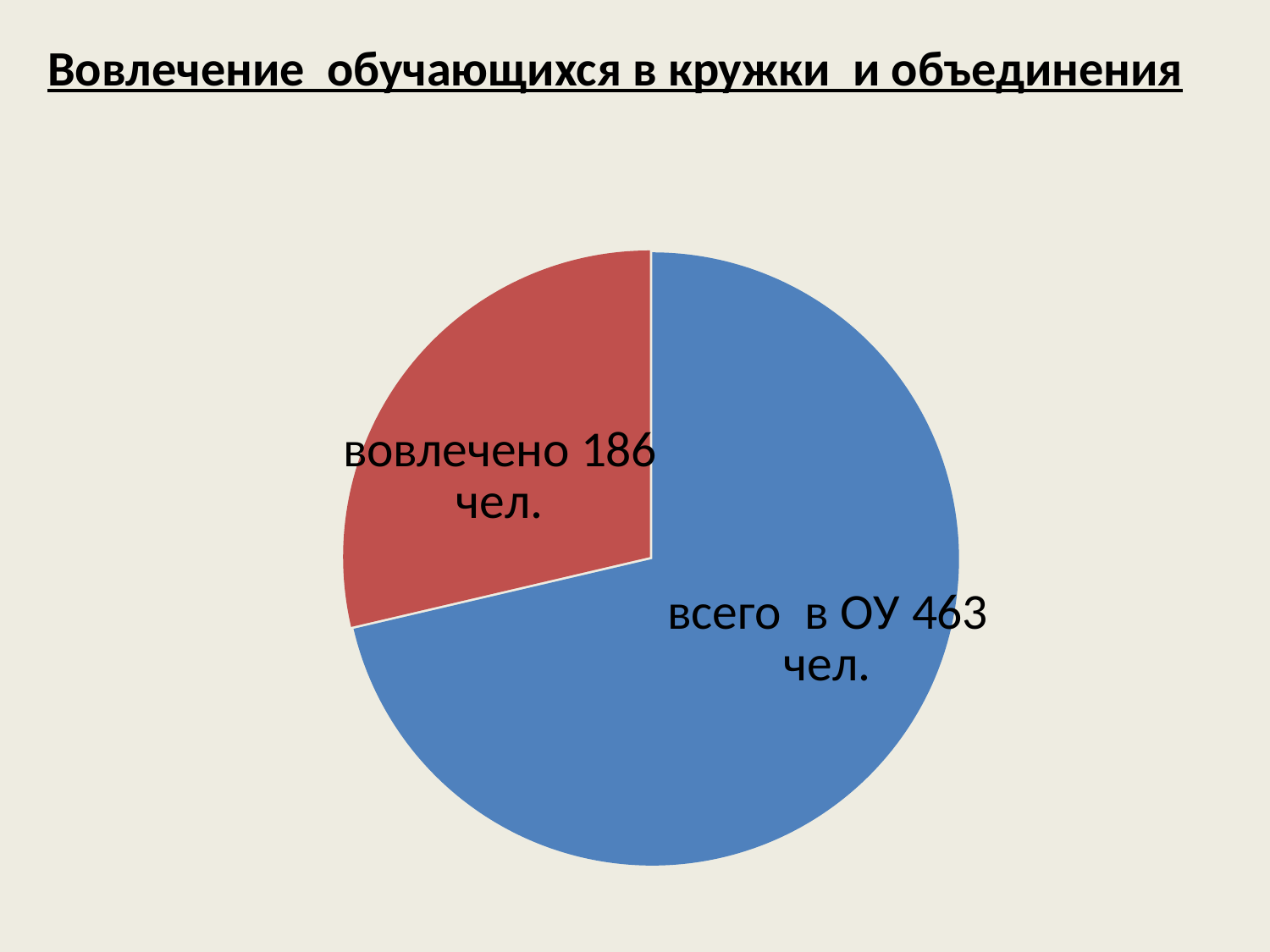
How many slices does the pie chart have? 2 What is the title of the chart on the slide? Вовлечение обучающихся в кружки и объединения What value is shown for the slice labelled "вовлечено"? 186 чел. What is the difference between the value for "всего в ОУ" and the value for "вовлечено"? 277 чел. What value is shown for the slice labelled "всего в ОУ"? 463 чел. Which is larger: the value for "вовлечено" or the value for "всего в ОУ"? всего в ОУ What kind of chart is shown on the slide? pie chart Which slice of the pie chart is the smallest? вовлечено 186 чел. Which slice of the pie chart is the largest? всего в ОУ 463 чел. What colour is the slice labelled "вовлечено 186 чел."? red